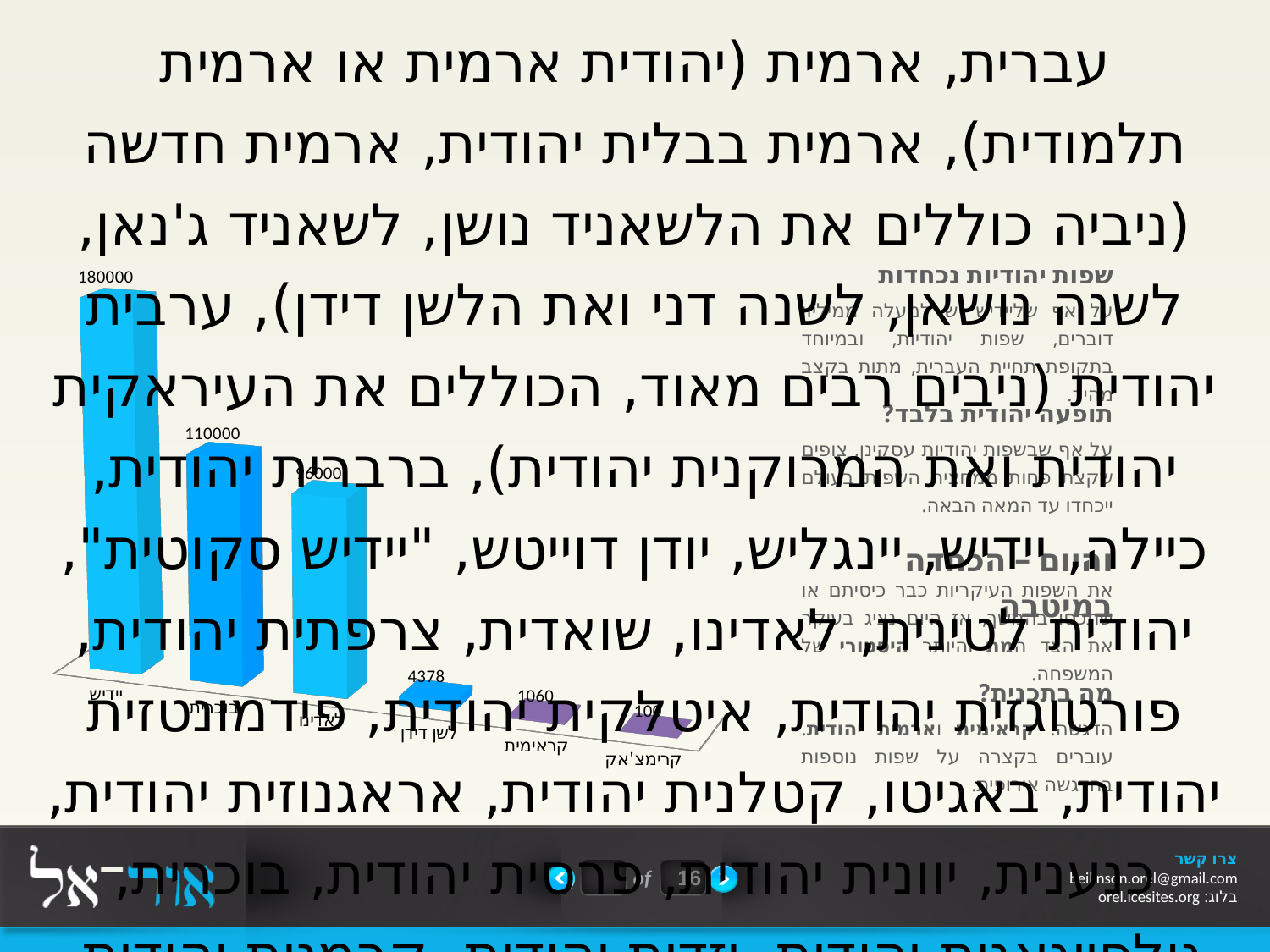
What value is labelled on the fifth bar from the left? 1060 What value is labelled on the second bar from the left? 110000 How many bars are plotted in the chart? 6 Which is larger, the first bar from the left or the second bar from the left? the first bar Which category has the tallest bar in the chart? יידיש What value is labelled on the bar for יידיש? 180000 What value is labelled on the fourth bar from the left? 4378 What is the difference between the tallest bar (180000) and the second tallest bar (110000)? 70000 What is the value shown on the tallest bar in the chart? 180000 Do the bar values rise or fall from left to right across the chart? fall What kind of chart is shown on the slide? bar chart